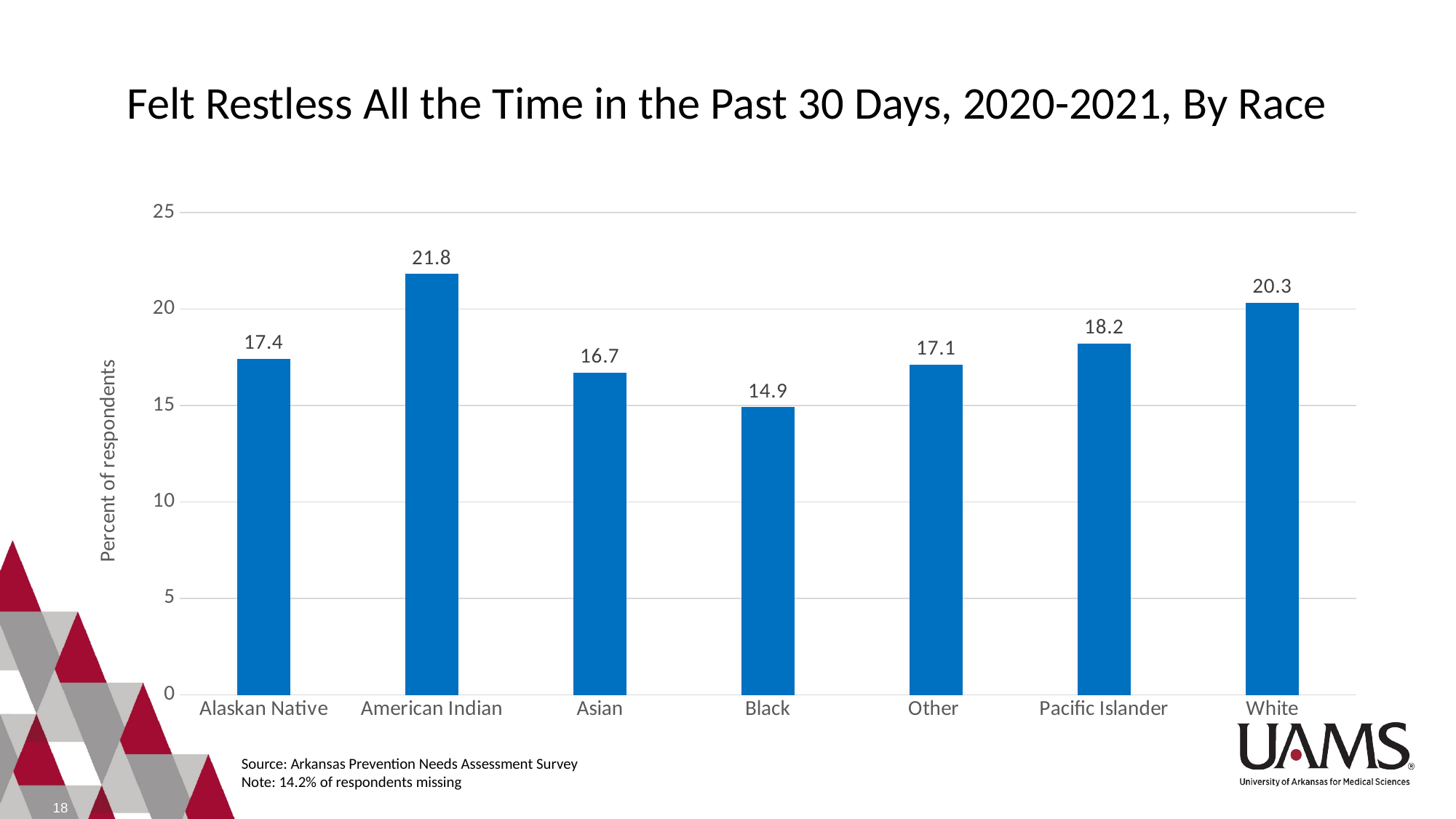
Is the value for White greater or less than 20? greater What is the value for Pacific Islander? 18.2 What is the difference between the values for American Indian and White? 1.5 How many race categories are shown in the chart? 7 What is the label of the vertical axis? Percent of respondents What is the difference between the values for Alaskan Native and Black? 2.5 Which is larger, the value for Asian or the value for Pacific Islander? Pacific Islander What kind of chart is shown on the slide? bar chart Which race has the lowest percent of respondents? Black What is the value for American Indian? 21.8 What is the value for Black? 14.9 Which race has the highest percent of respondents? American Indian